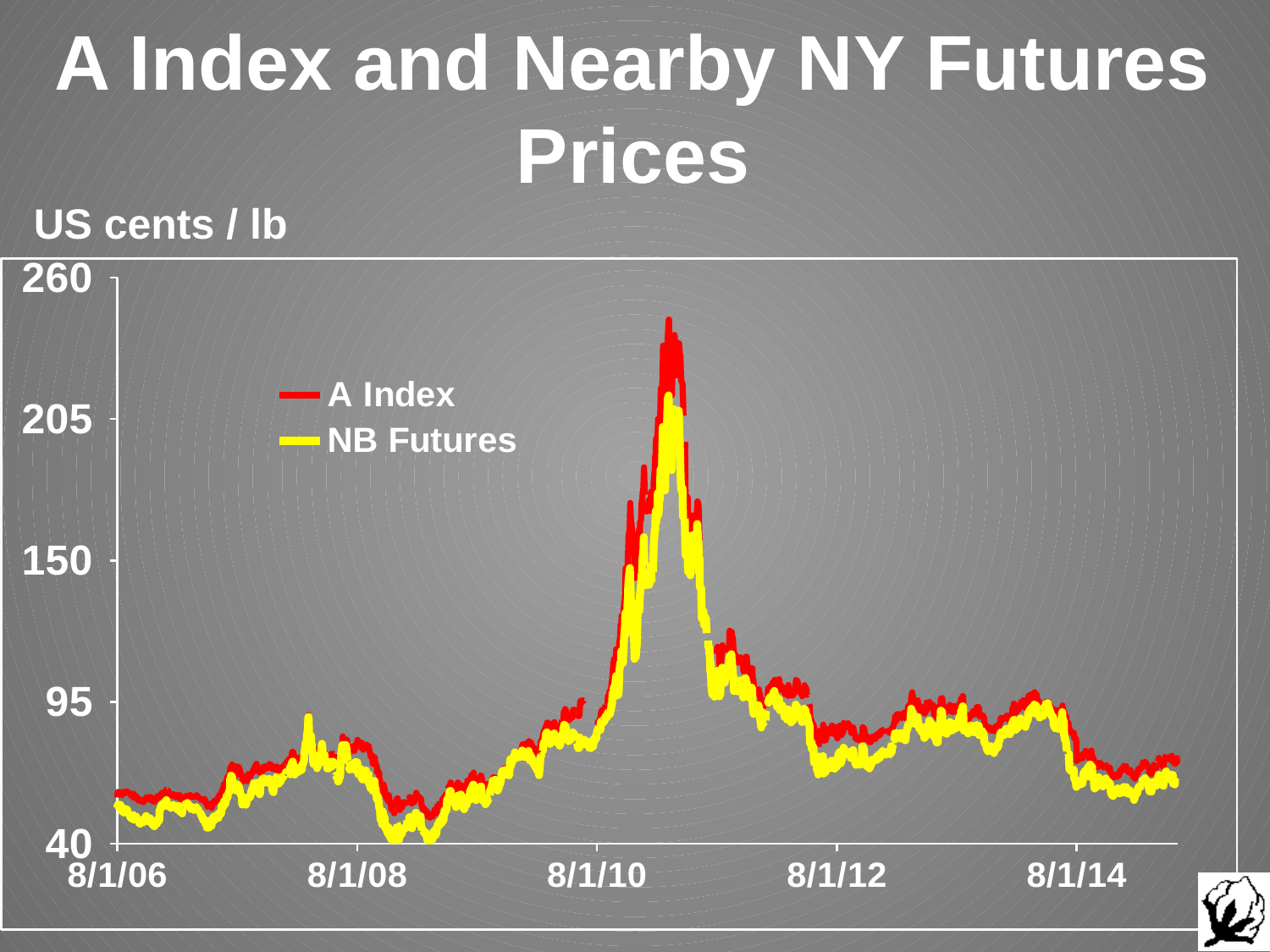
Is the peak value of the A Index series greater or less than 205? greater Is the A Index value at 8/1/06 greater or less than 95? less At the peak in early 2011, which series is higher, A Index or NB Futures? A Index Is the A Index value at 8/1/12 greater or less than 150? less Do prices rise or fall between the early 2011 peak and 8/1/12? fall How many date labels are shown on the x axis? 5 What kind of chart is shown on the slide? line chart How many series does the legend list? 2 What are the two series named in the legend? A Index and NB Futures Do prices rise or fall between 8/1/10 and the peak in early 2011? rise What unit is given for the y axis of the chart? US cents / lb